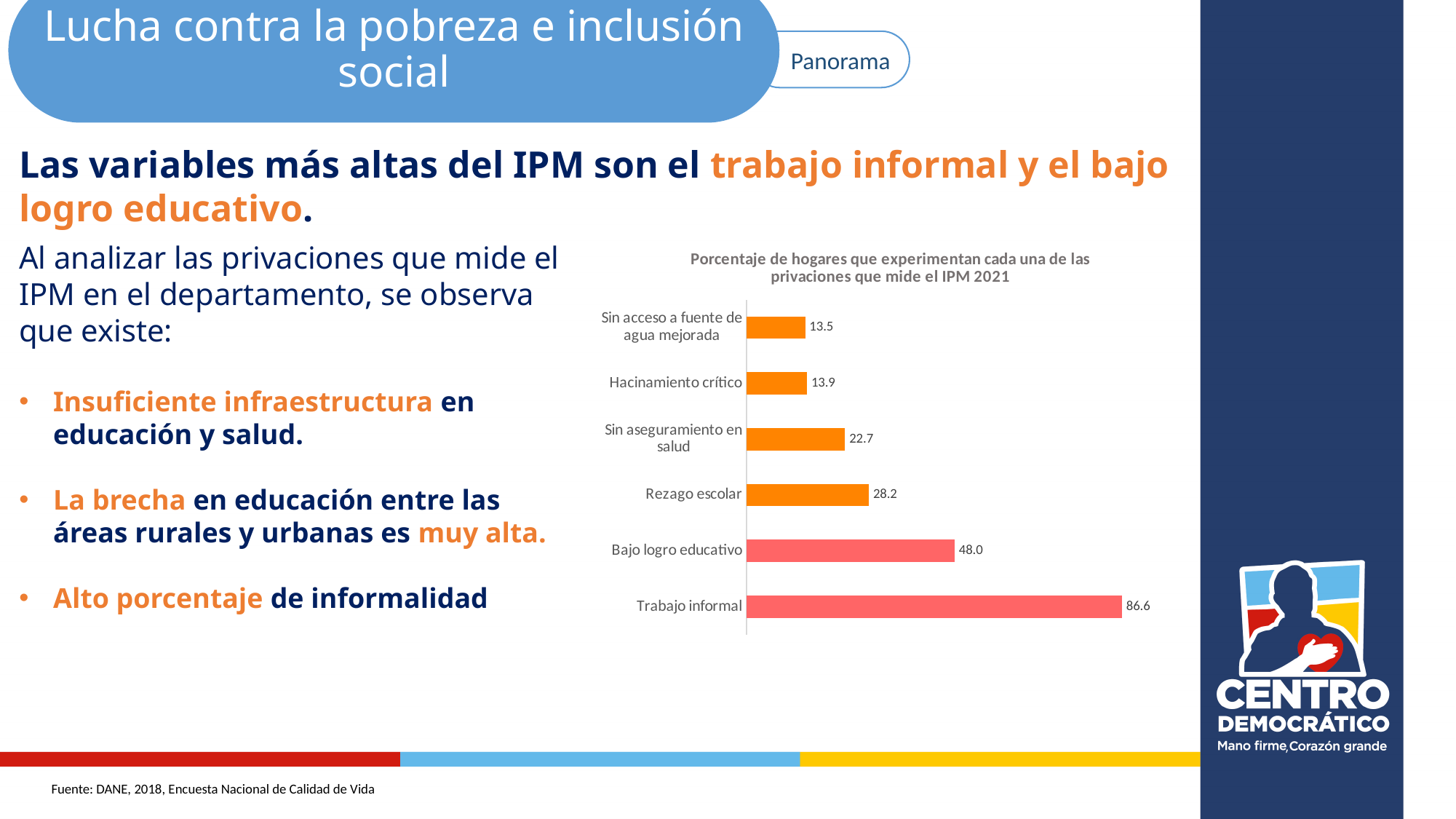
What kind of chart is shown on the slide? Bar chart What is the title of the chart? Porcentaje de hogares que experimentan cada una de las privaciones que mide el IPM 2021 Which is larger, the value for Rezago escolar or the value for Sin aseguramiento en salud? Rezago escolar What is the value for Rezago escolar? 28.2 What is the value for Hacinamiento crítico? 13.9 Which category has the highest value? Trabajo informal What is the value for Trabajo informal? 86.6 Which category has the lowest value? Sin acceso a fuente de agua mejorada How many categories are shown in the chart? 6 What is the value for Bajo logro educativo? 48.0 What is the value for Sin aseguramiento en salud? 22.7 What is the difference between the values for Trabajo informal and Bajo logro educativo? 38.6